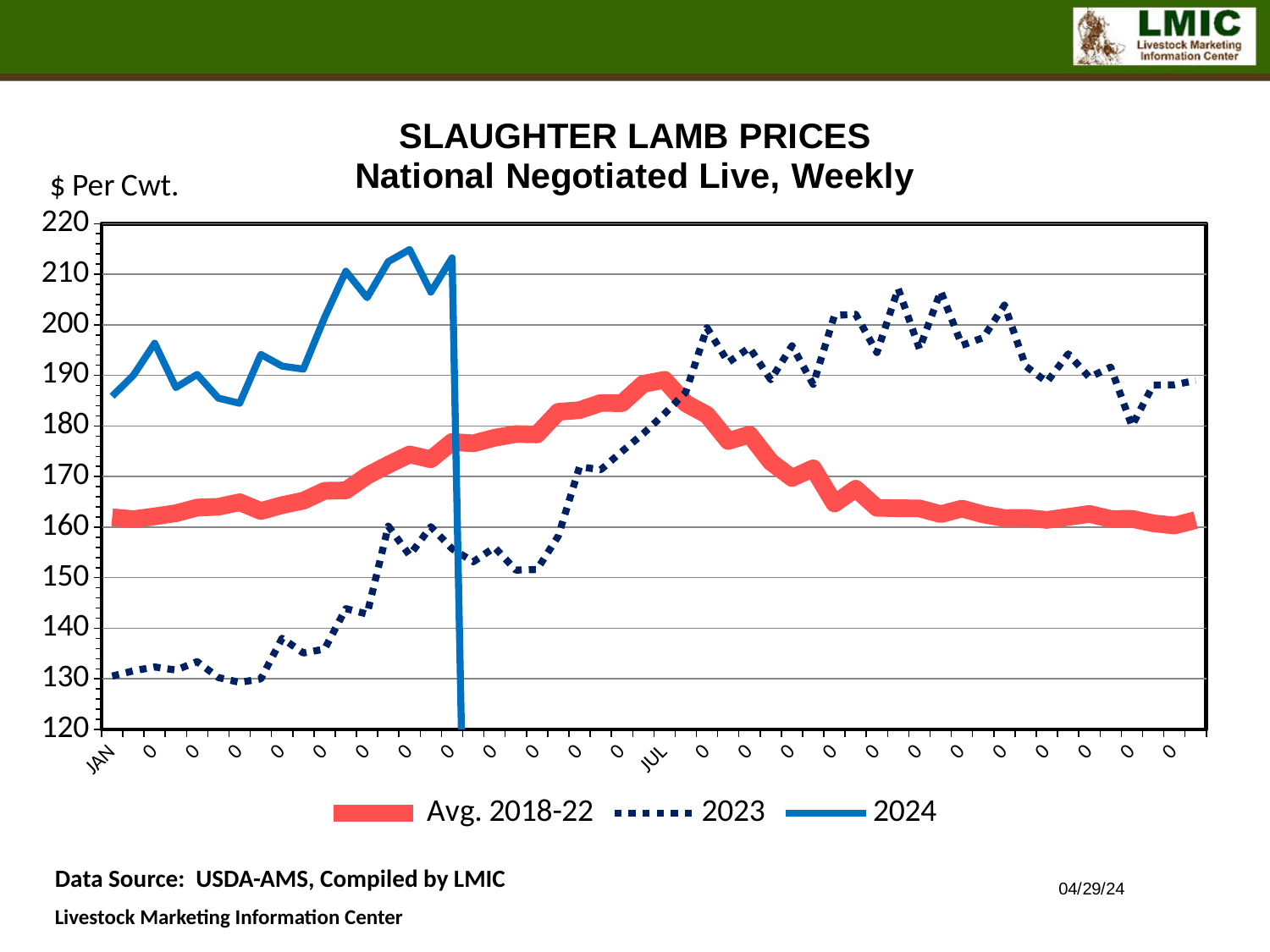
Does the Avg. 2018-22 line rise or fall from JAN to JUL? rise Which series has the lowest value at JAN? 2023 What are the three series listed in the legend? Avg. 2018-22, 2023, 2024 What is the unit label shown on the vertical axis? $ Per Cwt. Is the 2023 value at JAN greater or less than 140? less At JAN, which is larger: the 2024 value or the Avg. 2018-22 value? 2024 Is the Avg. 2018-22 value at JUL greater or less than 180? greater What kind of chart is shown on the slide? line chart Is the 2024 value at JAN greater or less than 180? greater Which series has the highest value at JAN? 2024 How many series does the legend list? 3